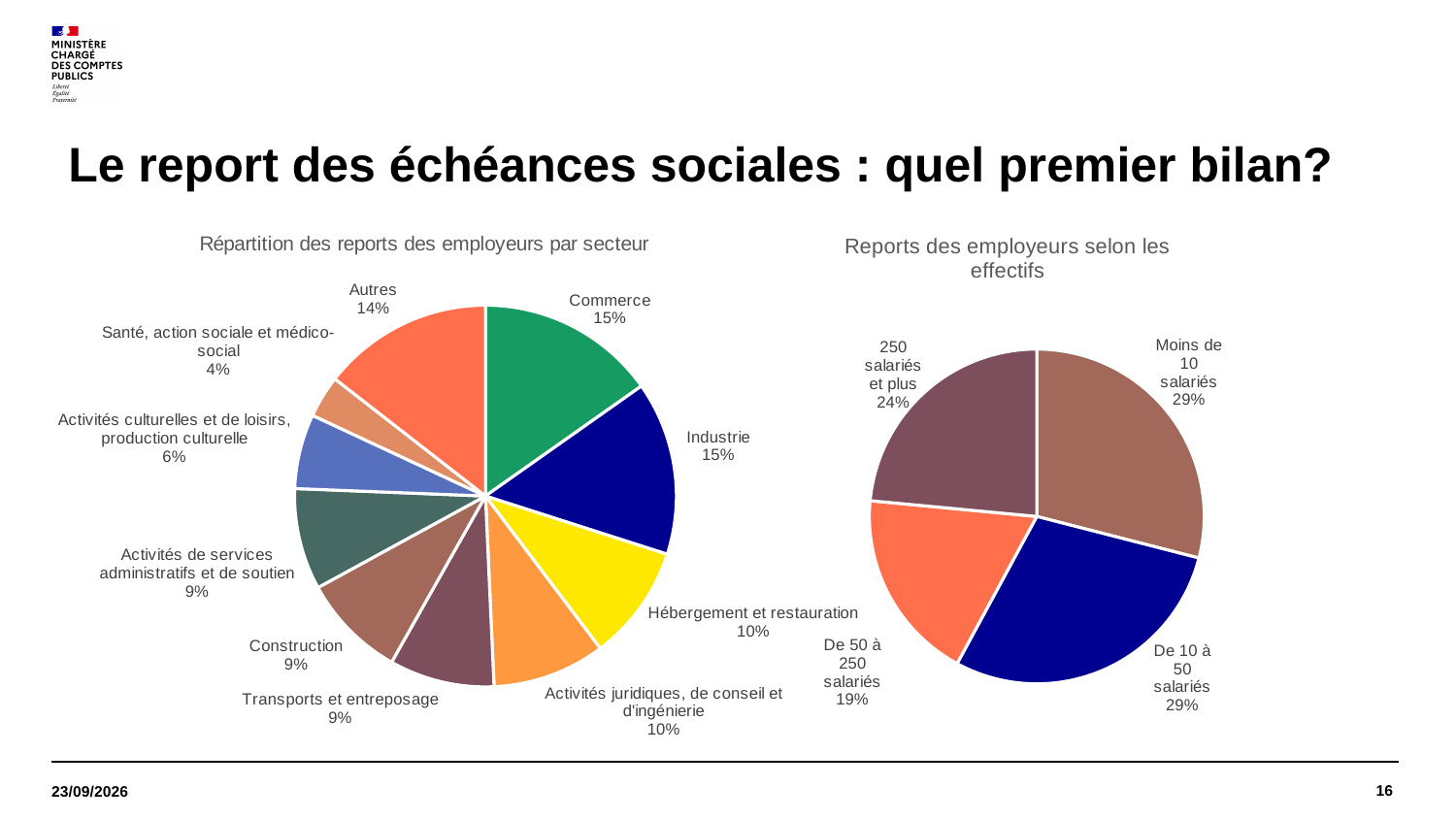
In the chart 'Répartition des reports des employeurs par secteur', what is the difference between the share of Autres and the share of Activités culturelles et de loisirs, production culturelle? 8 percentage points In the chart 'Répartition des reports des employeurs par secteur', what share does Hébergement et restauration represent? 10% In the chart 'Répartition des reports des employeurs par secteur', which sector has the smallest share? Santé, action sociale et médico-social In the chart 'Reports des employeurs selon les effectifs', how many categories are shown? 4 In the chart 'Répartition des reports des employeurs par secteur', which is larger: the share of Industrie or the share of Construction? Industrie What is the title of the pie chart on the left of the slide? Répartition des reports des employeurs par secteur What type of chart is 'Reports des employeurs selon les effectifs'? Pie chart In the chart 'Répartition des reports des employeurs par secteur', how many sectors (slices) are shown? 10 In the chart 'Reports des employeurs selon les effectifs', what is the difference between the share of Moins de 10 salariés and the share of De 50 à 250 salariés? 10 percentage points In the chart 'Reports des employeurs selon les effectifs', what share do employers with 250 salariés et plus represent? 24% In the chart 'Répartition des reports des employeurs par secteur', what share does Commerce represent? 15% In the chart 'Reports des employeurs selon les effectifs', which category has the smallest share? De 50 à 250 salariés